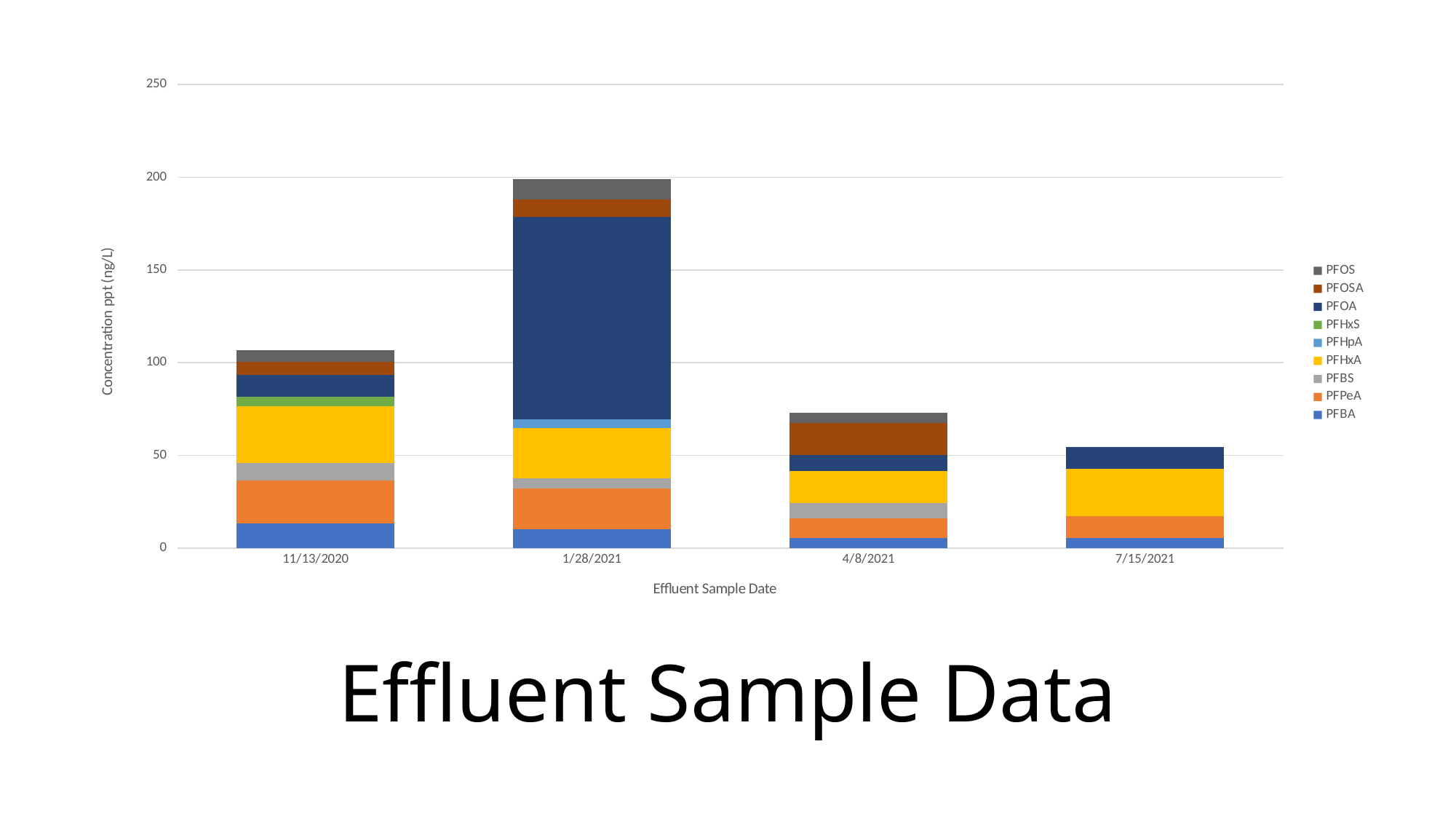
What kind of chart is shown on the slide? Stacked bar chart Is the total concentration for 1/28/2021 greater or less than 150? greater What is the label of the y axis? Concentration ppt (ng/L) Is the total concentration for 7/15/2021 greater or less than 100? less Which sample date has the highest total concentration? 1/28/2021 How many effluent sample dates are shown on the x axis? 4 Does the total concentration rise or fall from 1/28/2021 to 7/15/2021? fall How many series does the legend list? 9 Which has the larger total concentration, 11/13/2020 or 4/8/2021? 11/13/2020 Is the total concentration for 4/8/2021 greater or less than 100? less Which sample date has the lowest total concentration? 7/15/2021 What is the title shown below the chart? Effluent Sample Data